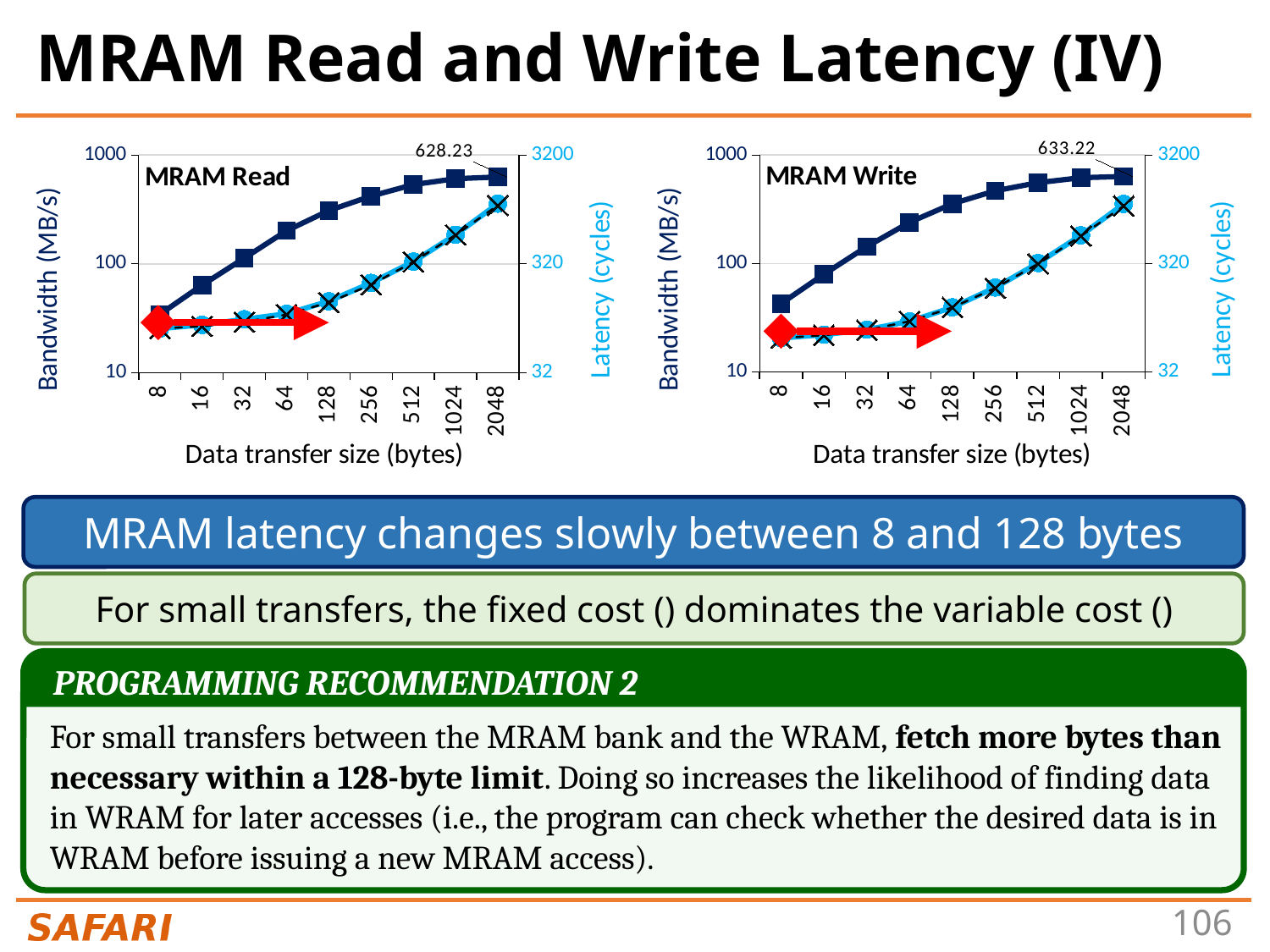
What is the x-axis title of the MRAM Write chart? Data transfer size (bytes) In the MRAM Read chart, how many data transfer sizes are shown on the x axis? 9 In the MRAM Read chart, at which data transfer size is the bandwidth highest? 2048 In the MRAM Write chart, is the latency at a data transfer size of 8 bytes greater or less than 320 cycles? less In the MRAM Read chart, is the bandwidth at a data transfer size of 8 bytes greater or less than 100 MB/s? less Comparing the labelled bandwidth at 2048 bytes, which chart shows the larger value, MRAM Read or MRAM Write? MRAM Write In the MRAM Read chart, what is the bandwidth value labelled at a data transfer size of 2048 bytes? 628.23 In the MRAM Write chart, is the bandwidth at a data transfer size of 512 bytes greater or less than 100 MB/s? greater In the MRAM Read chart, does bandwidth rise or fall as the data transfer size increases? Rise What is the difference between the labelled bandwidth at 2048 bytes in the MRAM Write chart and in the MRAM Read chart? 4.99 What kind of chart is the MRAM Write chart? Line chart In the MRAM Write chart, what is the bandwidth value labelled at a data transfer size of 2048 bytes? 633.22